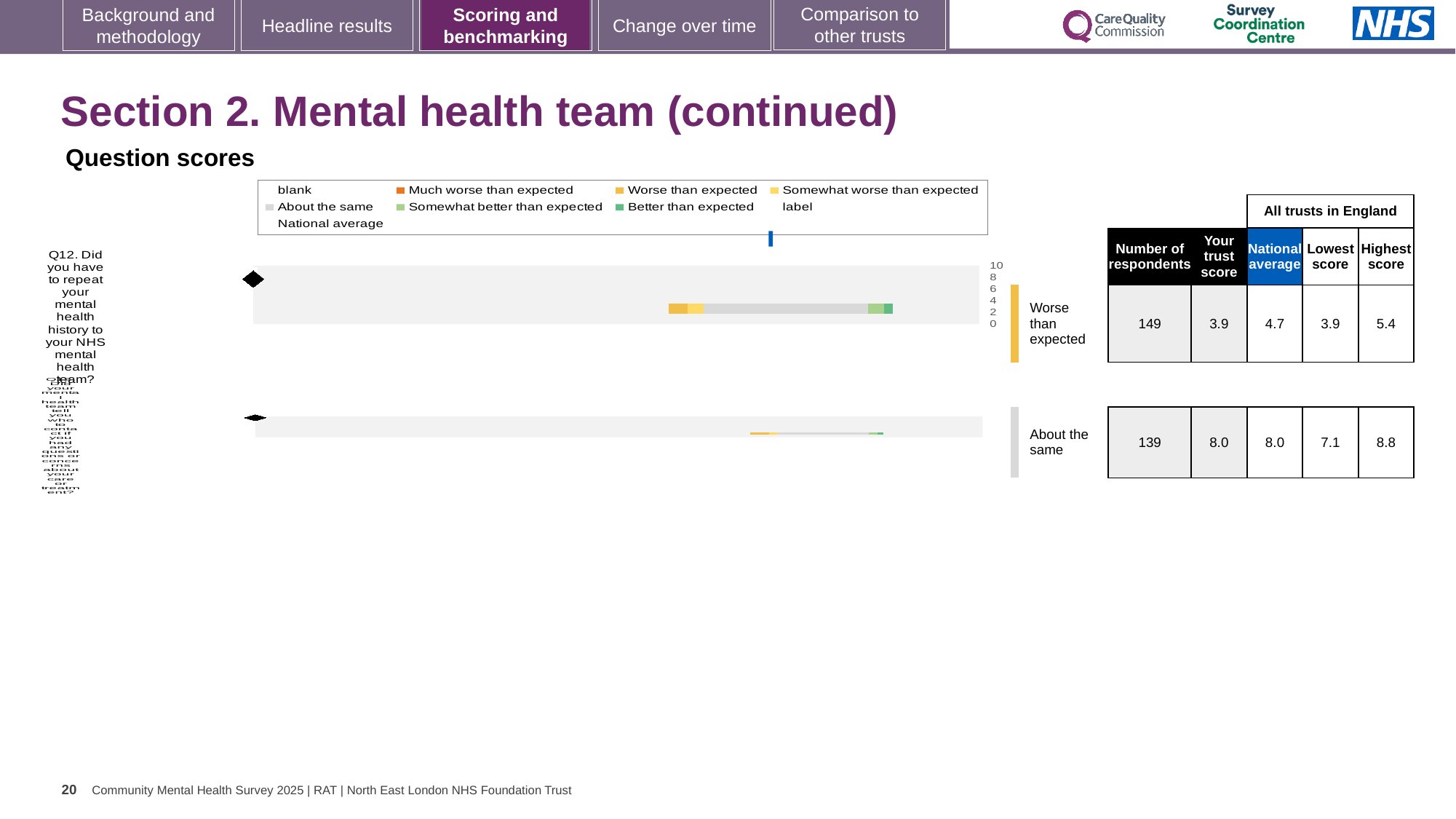
For Q12, which is larger: the trust's score or the national average? National average For the second question row, labelled 'About the same', how many respondents are shown? 139 What is the highest score among all trusts in England for Q12? 5.4 For the second question row, labelled 'About the same', what is the trust's score? 8.0 How many respondents are shown for Q12 (repeating your mental health history to your NHS mental health team)? 149 How many question rows are plotted on the chart? 2 What is the national average score for Q12? 4.7 Which benchmark category is Q12 placed in? Worse than expected What is the difference between the highest and lowest scores for Q12? 1.5 What kind of chart is used to show the question scores? Bar chart What is the lowest score among all trusts in England for Q12? 3.9 What is the trust's score for Q12? 3.9